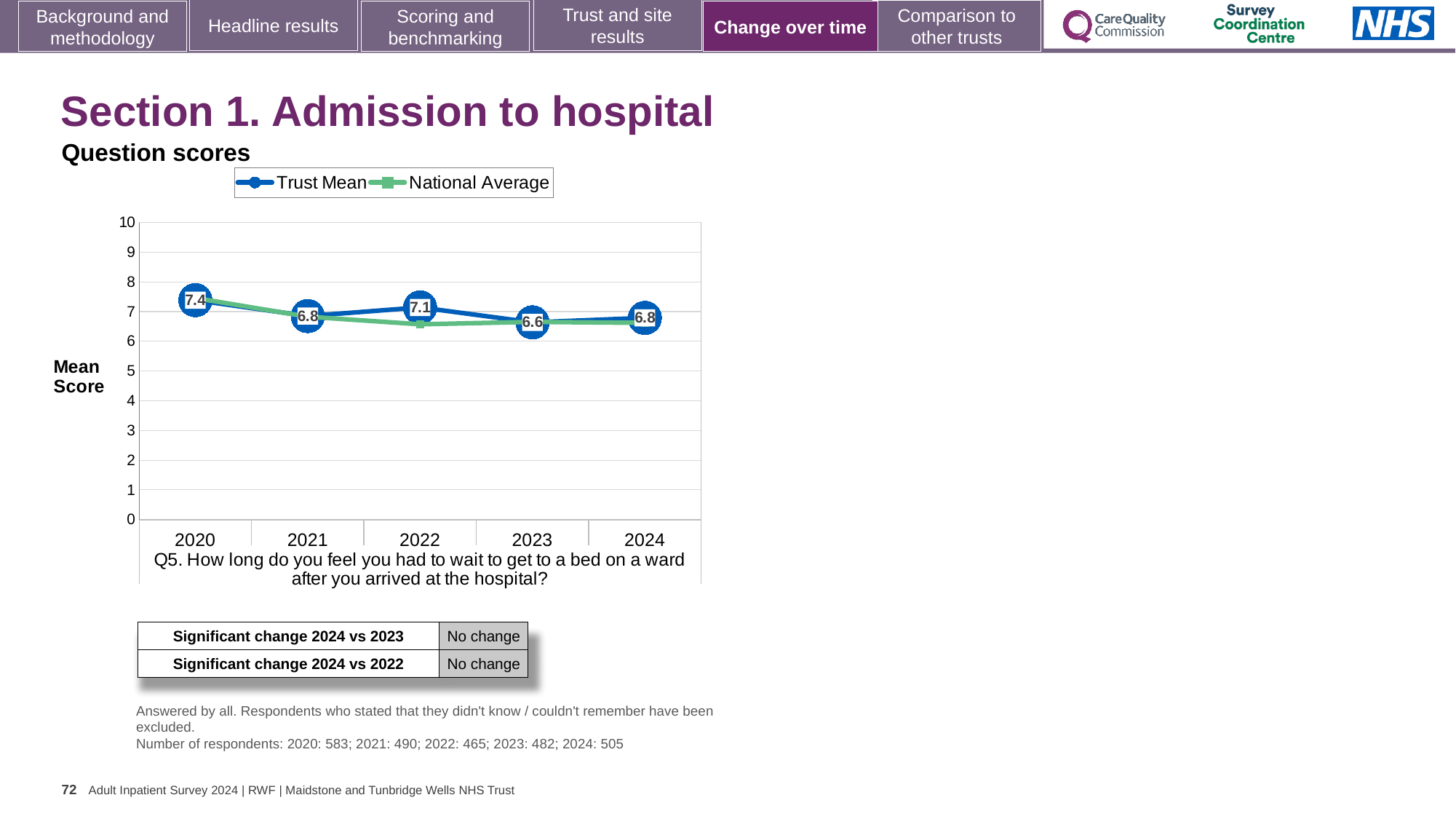
How many years are shown on the x axis of the chart? 5 How many series does the chart legend list? 2 What kind of chart is shown on the slide? Line chart What is the Trust Mean score for 2023? 6.6 What is the Trust Mean score for 2024? 6.8 What is the Trust Mean score for 2020? 7.4 Which year has the larger Trust Mean score, 2021 or 2022? 2022 Is the National Average value for 2022 greater or less than 7? less In which year is the Trust Mean score lowest? 2023 Did the Trust Mean score rise or fall from 2020 to 2021? Fall What is the difference between the Trust Mean score in 2020 and in 2023? 0.8 In which year is the Trust Mean score highest? 2020